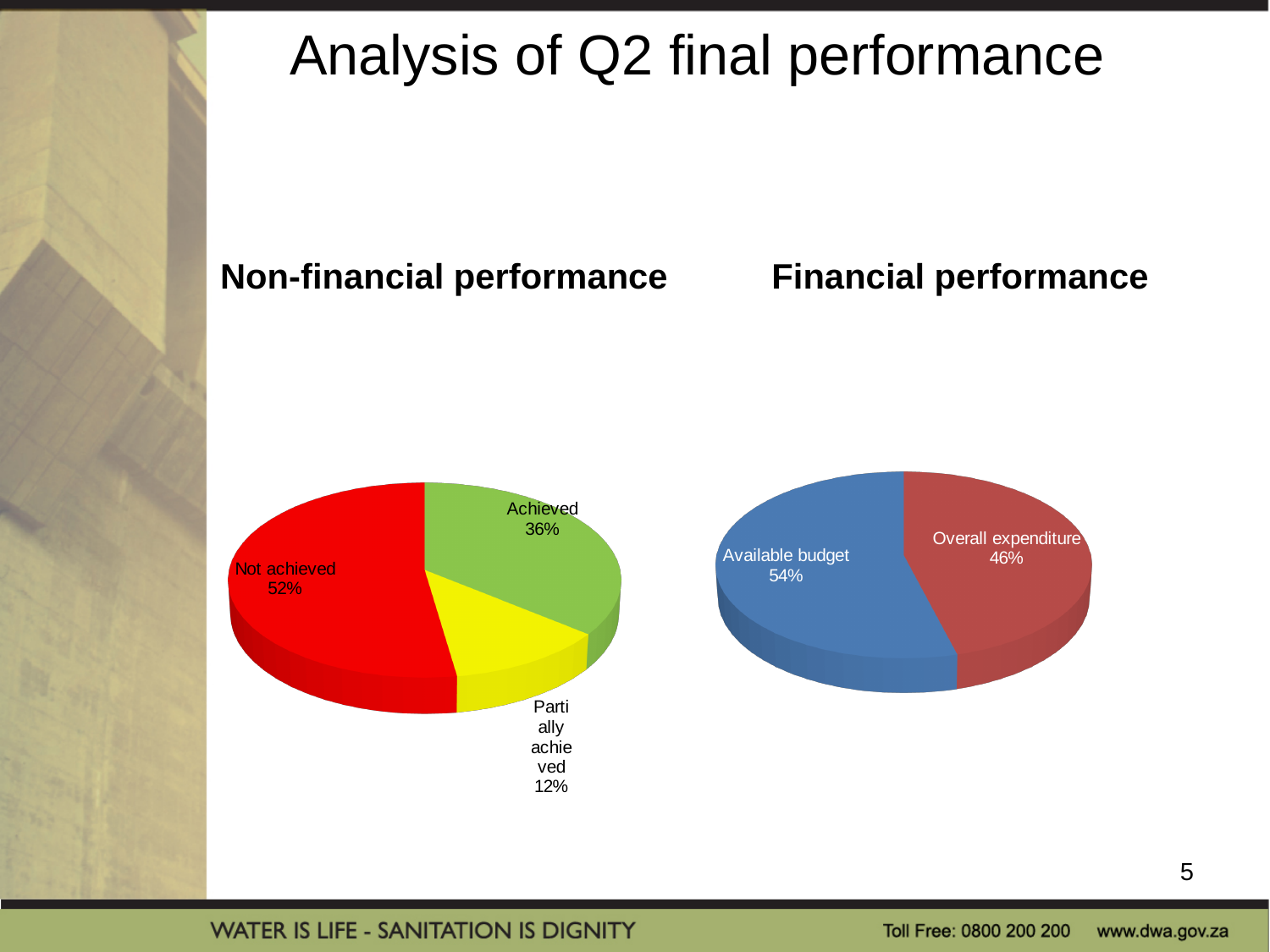
In the Non-financial performance pie chart, what share is labelled Achieved? 36% In the Financial performance pie chart, what share is labelled Available budget? 54% In the Financial performance pie chart, what share is labelled Overall expenditure? 46% In the Financial performance pie chart, what is the difference between the Available budget and Overall expenditure shares? 8% What type of chart is used for the Financial performance chart? Pie chart In the Non-financial performance pie chart, what share is labelled Partially achieved? 12% In the Non-financial performance pie chart, how many slices are there? 3 In the Financial performance pie chart, which is larger, Available budget or Overall expenditure? Available budget In the Non-financial performance pie chart, what share is labelled Not achieved? 52% In the Non-financial performance pie chart, what is the difference between the Not achieved and Achieved shares? 16% In the Non-financial performance pie chart, which category has the smallest share? Partially achieved In the Non-financial performance pie chart, which category has the largest share? Not achieved